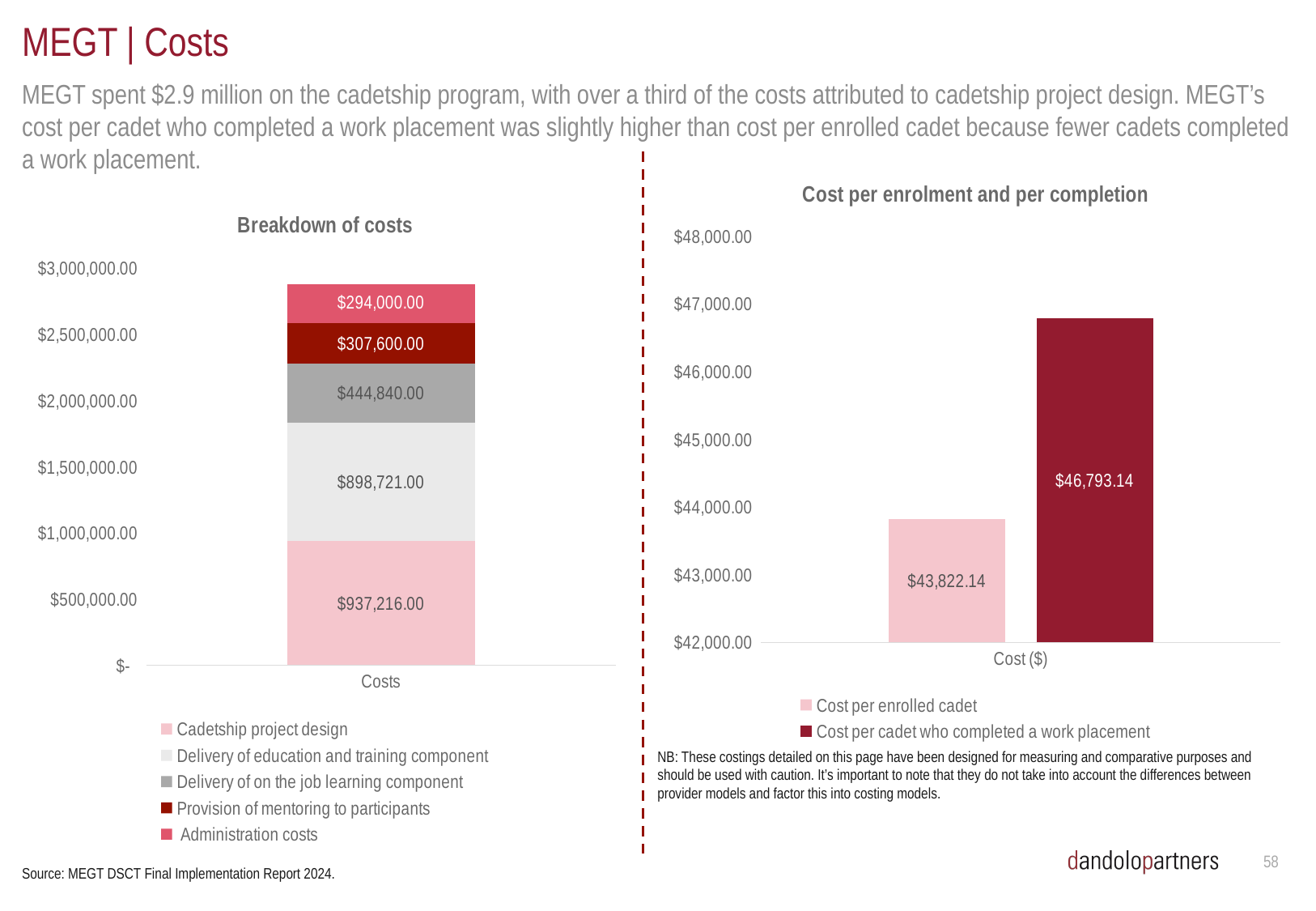
In the 'Breakdown of costs' chart, what is the difference between Provision of mentoring to participants and Administration costs? $13,600.00 In the 'Breakdown of costs' chart, what is the value for Delivery of on the job learning component? $444,840.00 In the 'Cost per enrolment and per completion' chart, what is the difference between the cost per cadet who completed a work placement and the cost per enrolled cadet? $2,971.00 In the 'Cost per enrolment and per completion' chart, what is the cost per cadet who completed a work placement? $46,793.14 In the 'Breakdown of costs' chart, what is the total of the stacked bar? $2,882,377.00 In the 'Breakdown of costs' chart, which cost component is the largest? Cadetship project design In the 'Cost per enrolment and per completion' chart, what is the cost per enrolled cadet? $43,822.14 What kind of chart is the 'Cost per enrolment and per completion' chart? Bar chart In the 'Breakdown of costs' chart, what is the value for Administration costs? $294,000.00 In the 'Breakdown of costs' chart, what is the value for Cadetship project design? $937,216.00 In the 'Breakdown of costs' chart, which cost component is the smallest? Administration costs How many series does the legend of the 'Breakdown of costs' chart list? 5